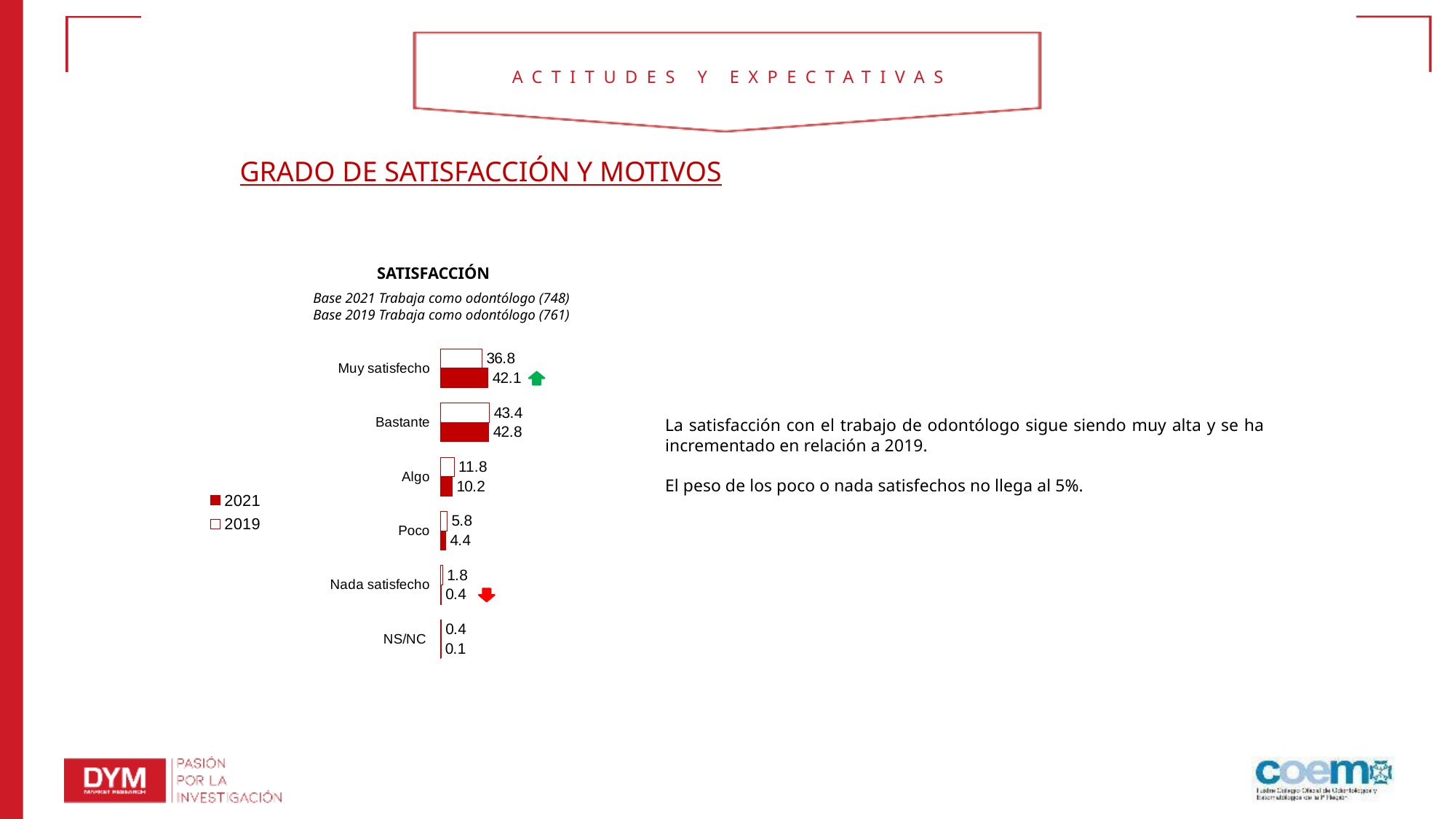
Which is larger for Poco: the 2019 value or the 2021 value? 2019 Which category has the lowest 2021 value? NS/NC What is the 2019 value for Bastante? 43.4 How many categories are shown in the chart? 6 How many series does the legend list? 2 What is the 2019 value for Nada satisfecho? 1.8 What is the 2021 value for Muy satisfecho? 42.1 Which category has the highest 2021 value? Bastante What is the title of the chart? SATISFACCIÓN What kind of chart is shown on the slide? Bar chart What is the difference between the 2021 and 2019 values for Muy satisfecho? 5.3 What is the 2021 value for Algo? 10.2